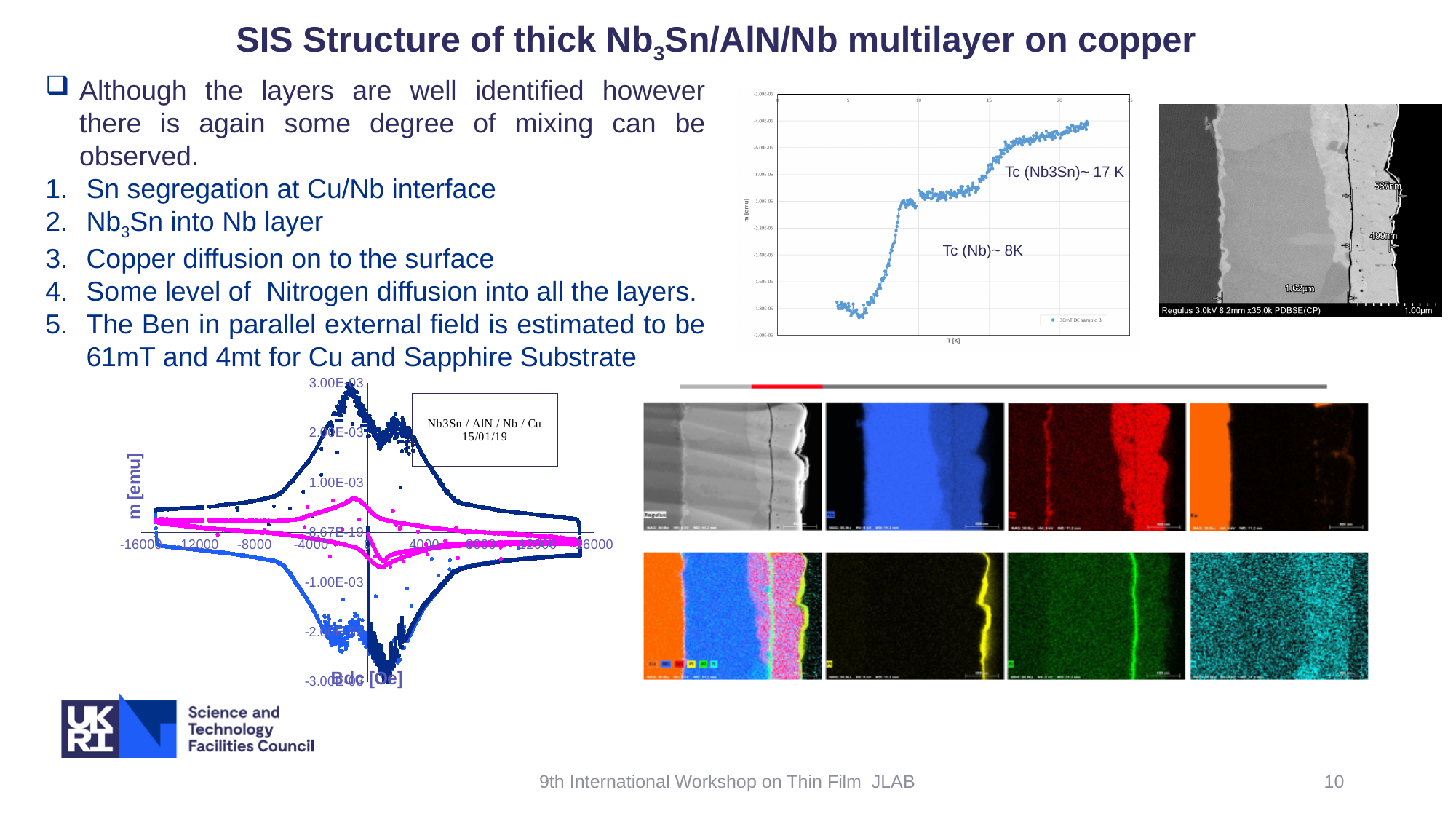
In the bottom-left chart, what is the maximum value shown on the x axis (Bdc [Oe])? 16000 In the top-right chart, what transition temperature is annotated for Nb? Tc (Nb)~ 8K In the top-right chart, is the value at about 20 K greater or less than -8.00E-06? greater In the top-right chart, what is the legend entry for the plotted series? 30mT DC sample B In the top-right chart, do the m [emu] values rise or fall as temperature increases from 5 K to 25 K? rise In the top-right chart, what is the label on the x axis? T [K] In the bottom-left chart, what is the label on the y axis? m [emu] In the bottom-left chart, what sample and date are given in the text box? Nb3Sn / AlN / Nb / Cu, 15/01/19 What kind of chart is the top-right chart plotting m [emu] against T [K]? scatter (line) chart In the top-right chart, is the value at about 5 K greater or less than -1.60E-05? less In the top-right chart, what transition temperature is annotated for Nb3Sn? Tc (Nb3Sn)~ 17 K In the top-right chart, how many series does the legend list? 1